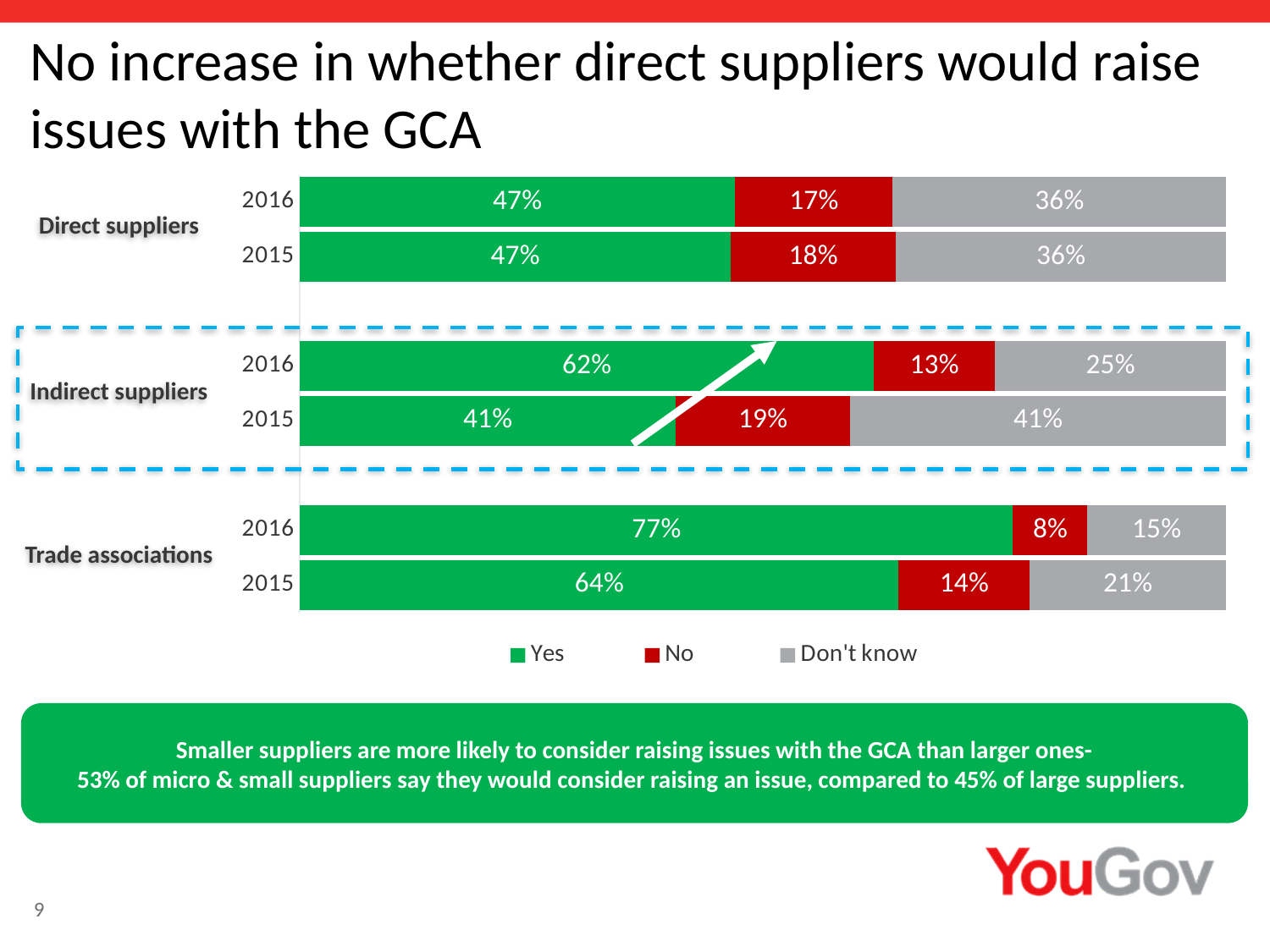
What percentage of trade associations answered "Don't know" in 2015? 21% Which group and year has the highest "Yes" percentage? Trade associations, 2016 What percentage of direct suppliers answered "No" in 2016? 17% What is the total of the 2016 bar for direct suppliers? 100% How many series does the legend list? 3 By how many percentage points did the "Yes" share for indirect suppliers change from 2015 to 2016? 21 percentage points What type of chart is shown on the slide? Stacked bar chart Which colour represents the "No" responses in the chart? Red Did the "Yes" share for trade associations rise or fall from 2015 to 2016? Rise Which group and year has the lowest "No" percentage? Trade associations, 2016 Which is larger: the "Don't know" share for indirect suppliers in 2015 or in 2016? 2015 What percentage of indirect suppliers answered "Yes" in 2016? 62%